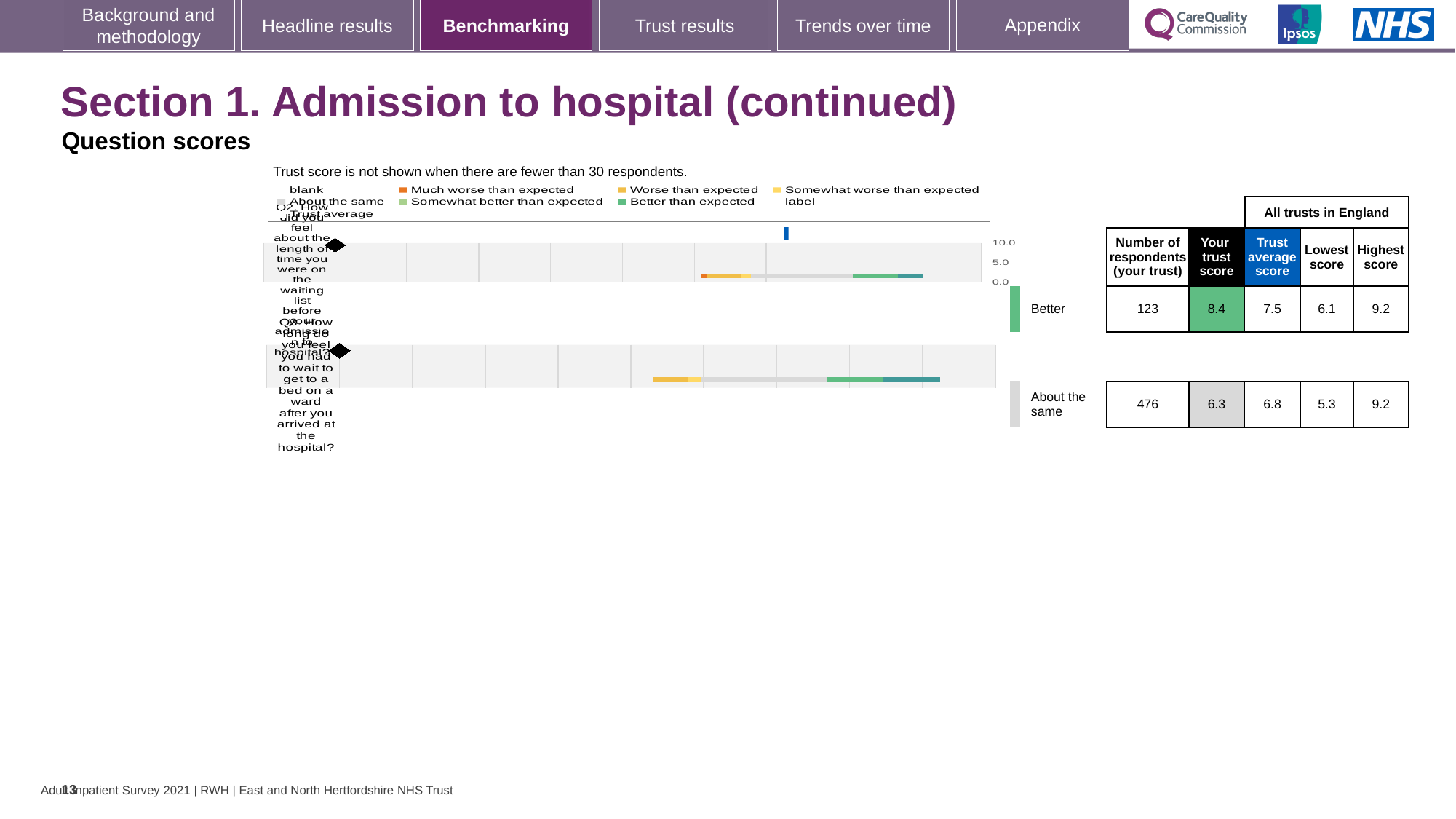
How many questions (bars) are plotted in the question scores chart? 2 What is the difference between the trust score and the trust average score for Q2? 0.9 What is the trust average score for Q2? 7.5 What benchmark category is shown next to the Q2 bar? Better What is the difference between the highest score and the lowest score for Q3? 3.9 What is the trust score for Q2 (length of time on the waiting list before admission)? 8.4 Which question has the higher trust score, Q2 or Q3? Q2 What is the number of respondents for Q3? 476 What kind of chart is used to show the question scores on this slide? bar chart Is the trust score for Q3 greater or less than 5.0? greater What is the trust score for Q3 (wait to get to a bed on a ward after arriving at the hospital)? 6.3 What is the lowest score across all trusts in England for Q3? 5.3